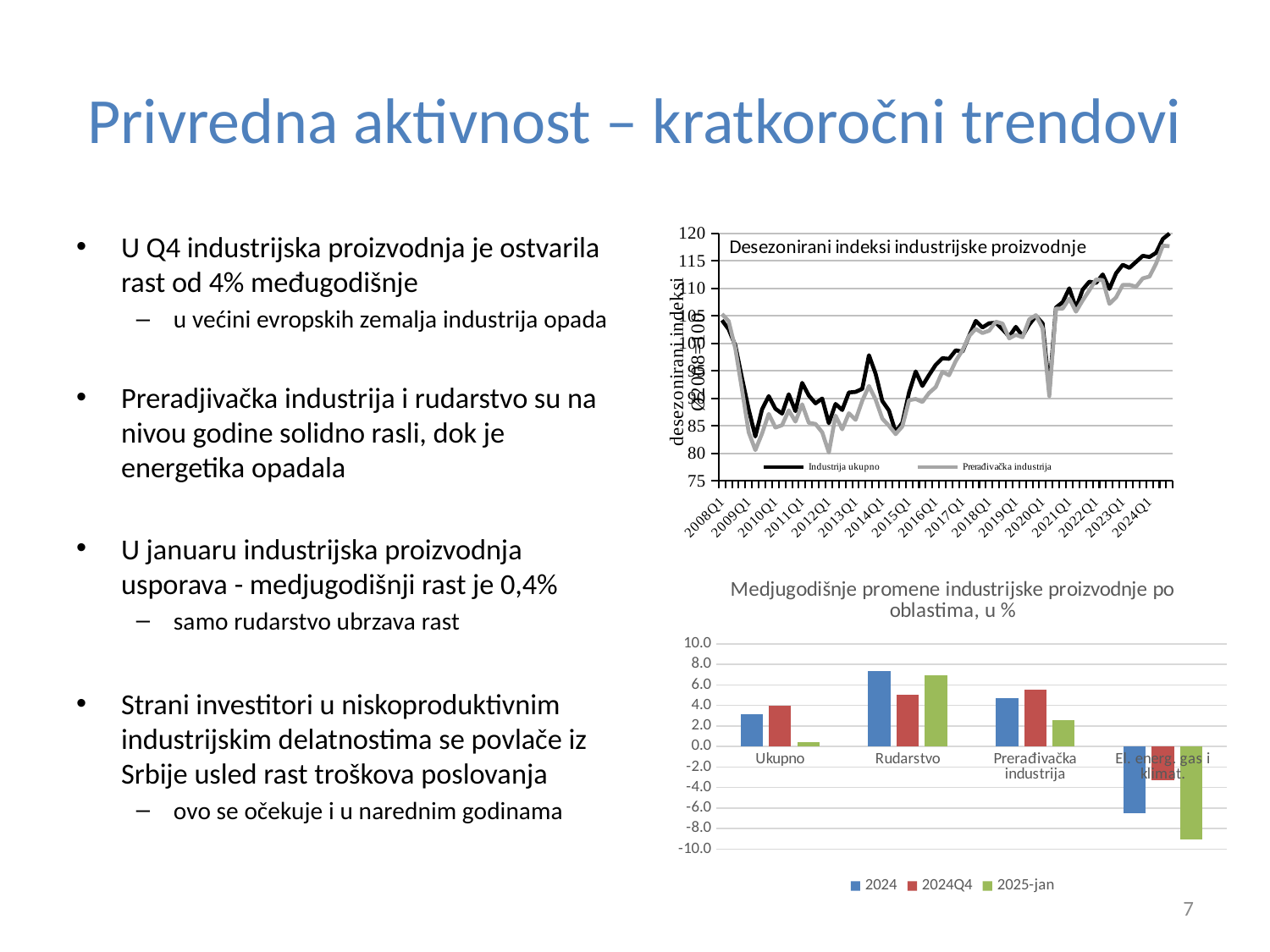
How many series does the legend of the bottom chart 'Medjugodišnje promene industrijske proizvodnje po oblastima, u %' list? 3 In the bottom chart 'Medjugodišnje promene industrijske proizvodnje po oblastima, u %', which category has the lowest 2025-jan value? El. energ. gas i klimat. In the top chart 'Desezonirani indeksi industrijske proizvodnje', which series is drawn in black? Industrija ukupno How many categories are shown on the x axis of the bottom chart 'Medjugodišnje promene industrijske proizvodnje po oblastima, u %'? 4 What type of chart is the bottom chart 'Medjugodišnje promene industrijske proizvodnje po oblastima, u %'? bar chart In the bottom chart 'Medjugodišnje promene industrijske proizvodnje po oblastima, u %', which is larger for Ukupno: the 2024 value or the 2025-jan value? 2024 In the top chart 'Desezonirani indeksi industrijske proizvodnje', do the values overall rise or fall from 2016Q1 to 2024Q1? rise In the bottom chart 'Medjugodišnje promene industrijske proizvodnje po oblastima, u %', which category has the highest 2024 value? Rudarstvo In the bottom chart 'Medjugodišnje promene industrijske proizvodnje po oblastima, u %', is the 2024 value for Rudarstvo greater or less than 6.0? greater What type of chart is the top chart titled 'Desezonirani indeksi industrijske proizvodnje'? line chart How many series does the legend of the top chart 'Desezonirani indeksi industrijske proizvodnje' list? 2 In the bottom chart 'Medjugodišnje promene industrijske proizvodnje po oblastima, u %', is the 2025-jan value for El. energ. gas i klimat. greater or less than -8.0? less